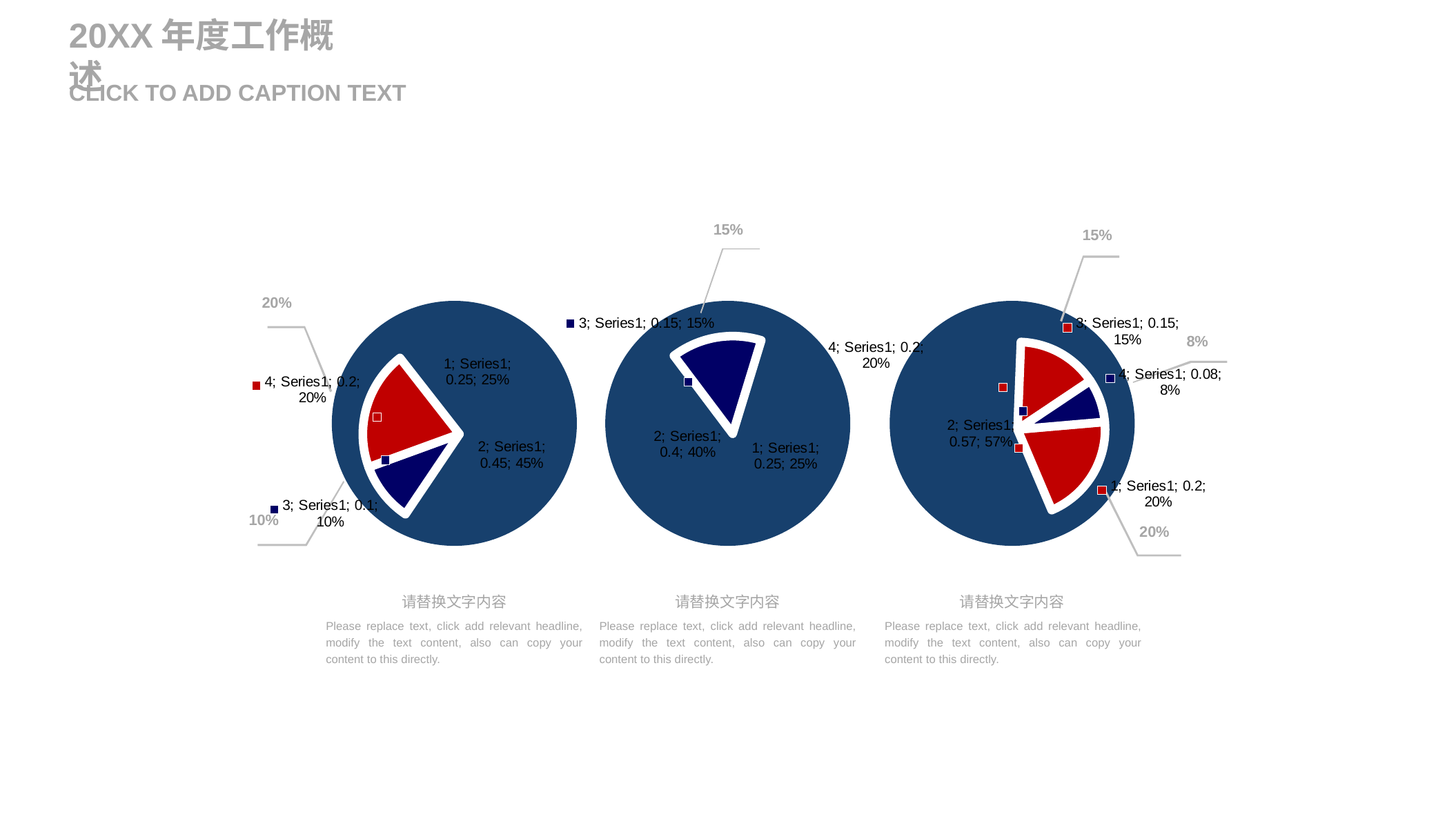
In the left pie chart, what percentage is shown for category 3? 10% In the left pie chart, what percentage is shown for category 2? 45% In the right pie chart, what percentage is shown for category 2? 57% In the right pie chart, what percentage is shown for category 4? 8% How many categories does the right pie chart show? 4 In the middle pie chart, what percentage is shown for category 2? 40% In the left pie chart, which category has the largest share? 2 In the middle pie chart, what is the difference in percentage points between category 2 and category 1? 15 In the right pie chart, which is larger, category 1 or category 3? category 1 In the left pie chart, which category has the smallest share? 3 In the middle pie chart, what percentage is shown for category 3? 15% What kind of chart is the left chart on the slide? pie chart